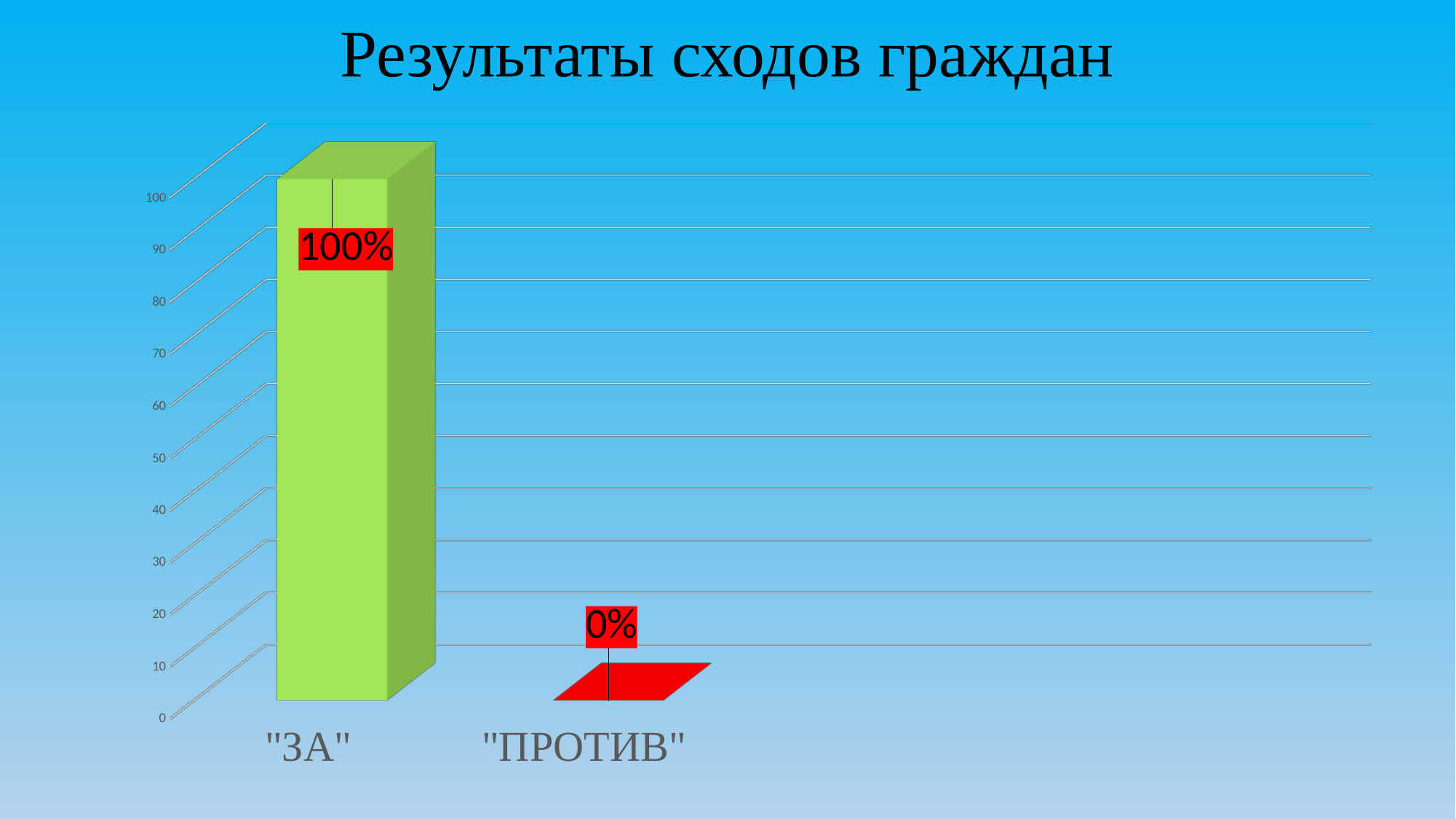
Which category has the lowest value? "ПРОТИВ" Which category has the highest value? "ЗА" What is the value for "ПРОТИВ"? 0% Is the value for "ЗА" greater or less than 50? greater What is the value for "ЗА"? 100% What colour is the bar for "ЗА"? green What is the difference between the values for "ЗА" and "ПРОТИВ"? 100% What kind of chart is shown on the slide? bar chart What is the highest tick value shown on the vertical axis? 100 What is the title of the chart? Результаты сходов граждан How many categories are shown on the x axis? 2 Which is larger, the value for "ЗА" or the value for "ПРОТИВ"? "ЗА"